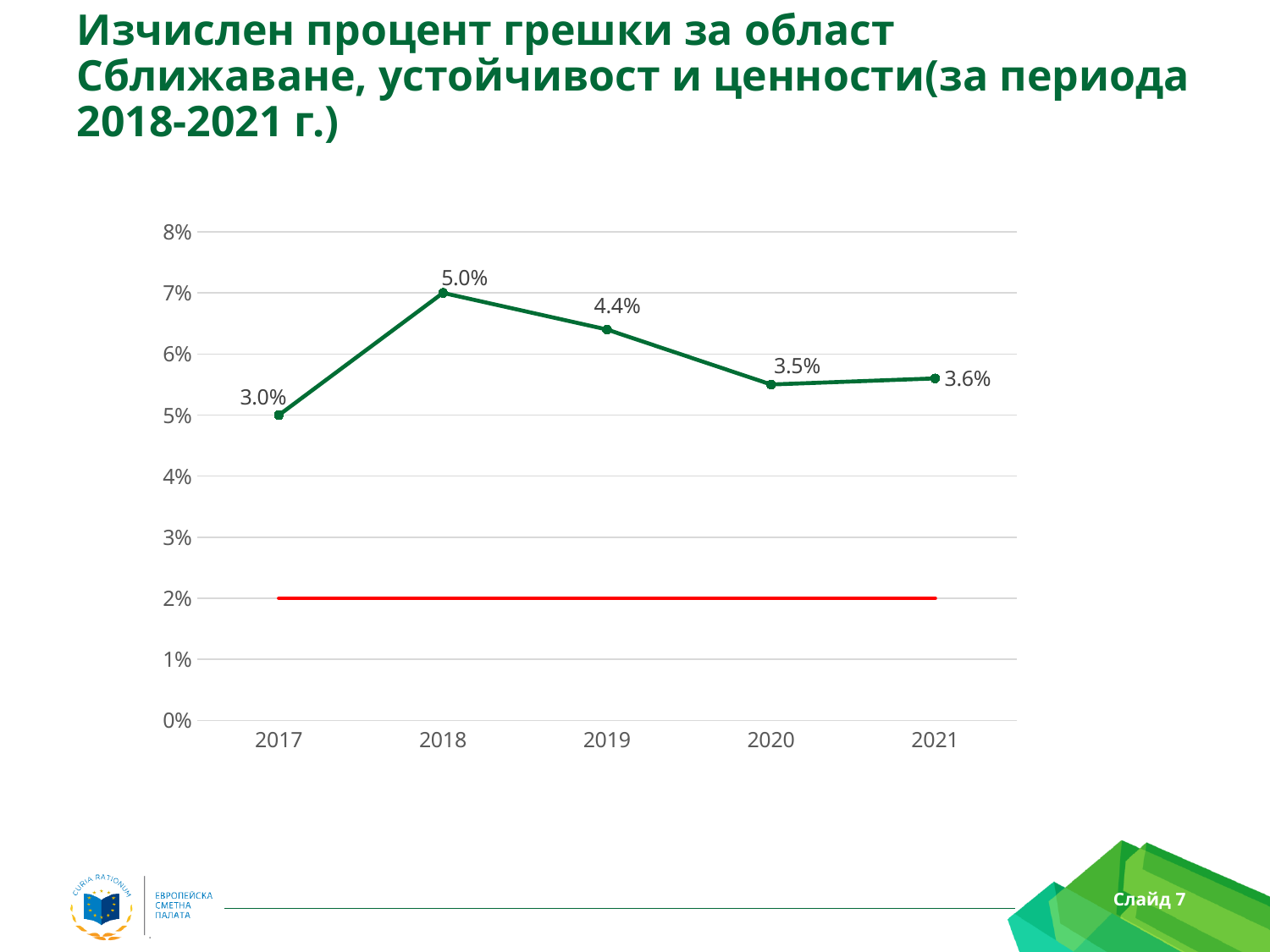
Which year has the lowest value? 2017 What is the difference between the values for 2019 and 2020? 0.9 percentage points What is the value for 2019? 4.4% Which is larger, the value for 2020 or the value for 2021? 2021 Which year has the highest value? 2018 What kind of chart is shown on the slide? Line chart At what level on the y axis is the horizontal red line drawn? 2% What is the value for 2021? 3.6% Do the values rise or fall from 2018 to 2020? Fall What is the difference between the values for 2018 and 2017? 2.0 percentage points What is the value for 2018? 5.0% How many years are plotted on the x axis? 5